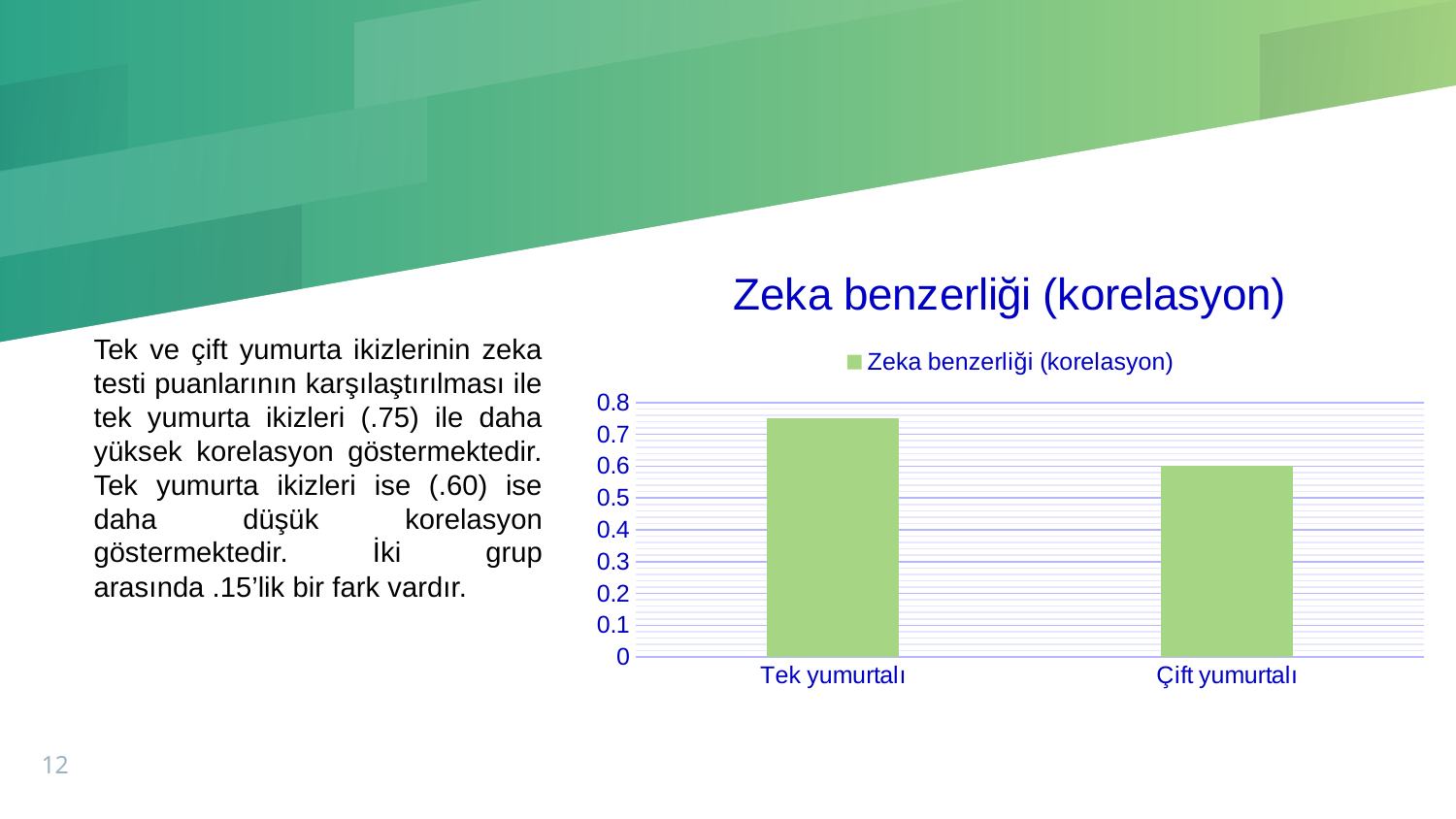
What kind of chart is shown on the slide? bar chart Which is larger, the value for Tek yumurtalı or the value for Çift yumurtalı? Tek yumurtalı What is the title of the chart? Zeka benzerliği (korelasyon) Is the value for Tek yumurtalı greater or less than 0.8? less What is the value for Çift yumurtalı in the chart? 0.6 How many categories are plotted on the x axis of the chart? 2 Is the value for Çift yumurtalı greater or less than 0.7? less Is the value for Tek yumurtalı greater or less than 0.7? greater Which category has the lowest value in the chart? Çift yumurtalı What series name is shown in the chart's legend? Zeka benzerliği (korelasyon) Which category has the highest value in the chart? Tek yumurtalı How many series does the chart's legend list? 1